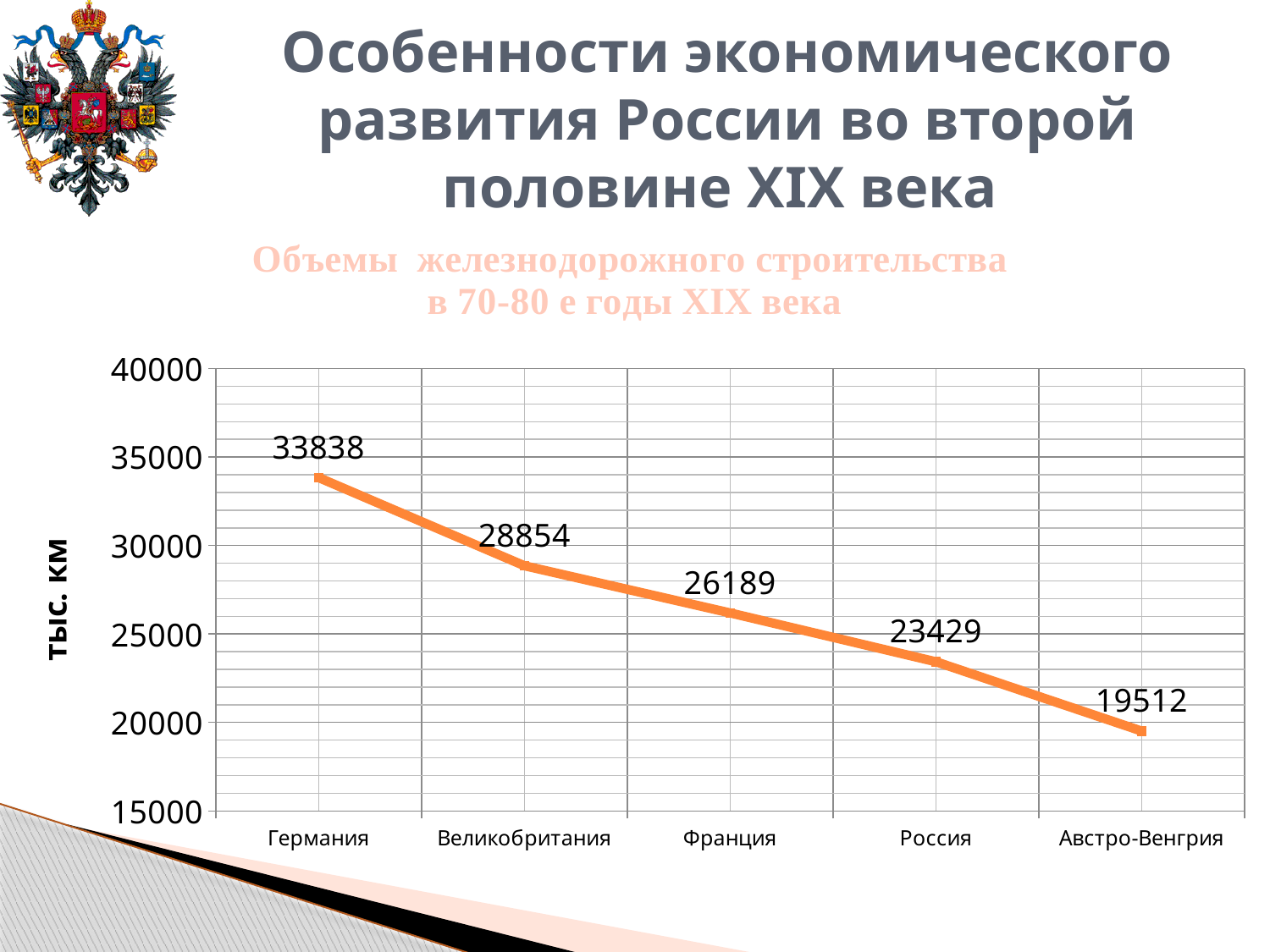
Which is larger, the value for Великобритания or the value for Франция? Великобритания What is the value for Германия? 33838 Is the value for Великобритания greater or less than 30000? less Which country has the lowest value? Австро-Венгрия What kind of chart is shown on the slide? line chart How many countries are plotted on the chart? 5 What is the value for Австро-Венгрия? 19512 What is the difference between the values for Германия and Россия? 10409 What is the value for Россия? 23429 What is the value for Франция? 26189 Which country has the highest value? Германия Do the values rise or fall from left to right along the x axis? fall